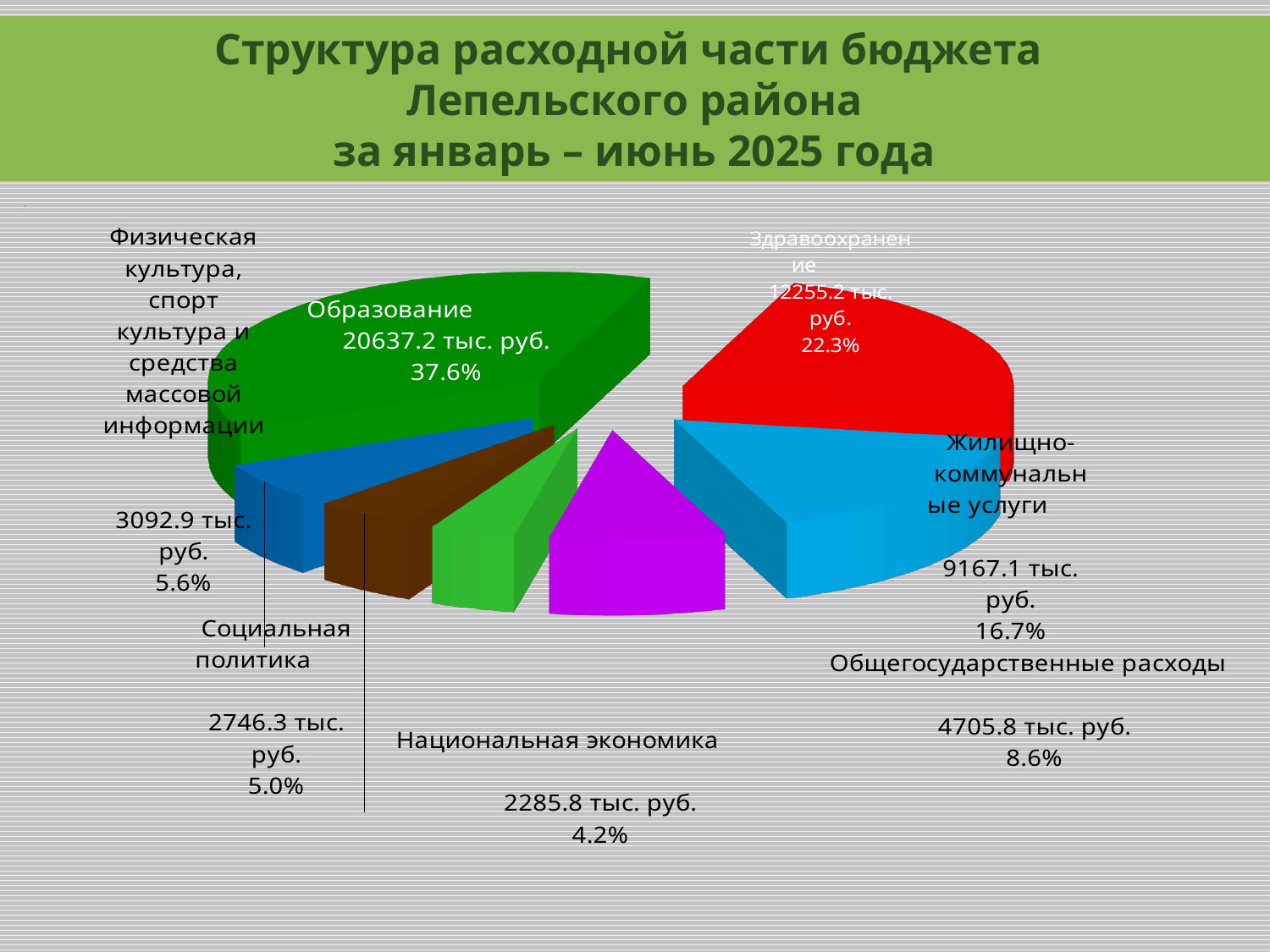
How many slices does the pie chart have? 7 Which category has the smallest share of the pie? Национальная экономика Which is larger, Социальная политика or Физическая культура, спорт, культура и средства массовой информации? Физическая культура, спорт, культура и средства массовой информации What is the difference between the values for Социальная политика and Национальная экономика? 460.5 тыс. руб. What percentage is shown for Общегосударственные расходы? 8.6% What is the value for Образование? 20637.2 тыс. руб. What share of the pie does Здравоохранение take? 22.3% What is the value for Жилищно-коммунальные услуги? 9167.1 тыс. руб. What is the difference in percentage points between Образование and Здравоохранение? 15.3 What is the title of the chart? Структура расходной части бюджета Лепельского района за январь – июнь 2025 года Which category has the largest share of the pie? Образование What kind of chart is shown on the slide? pie chart